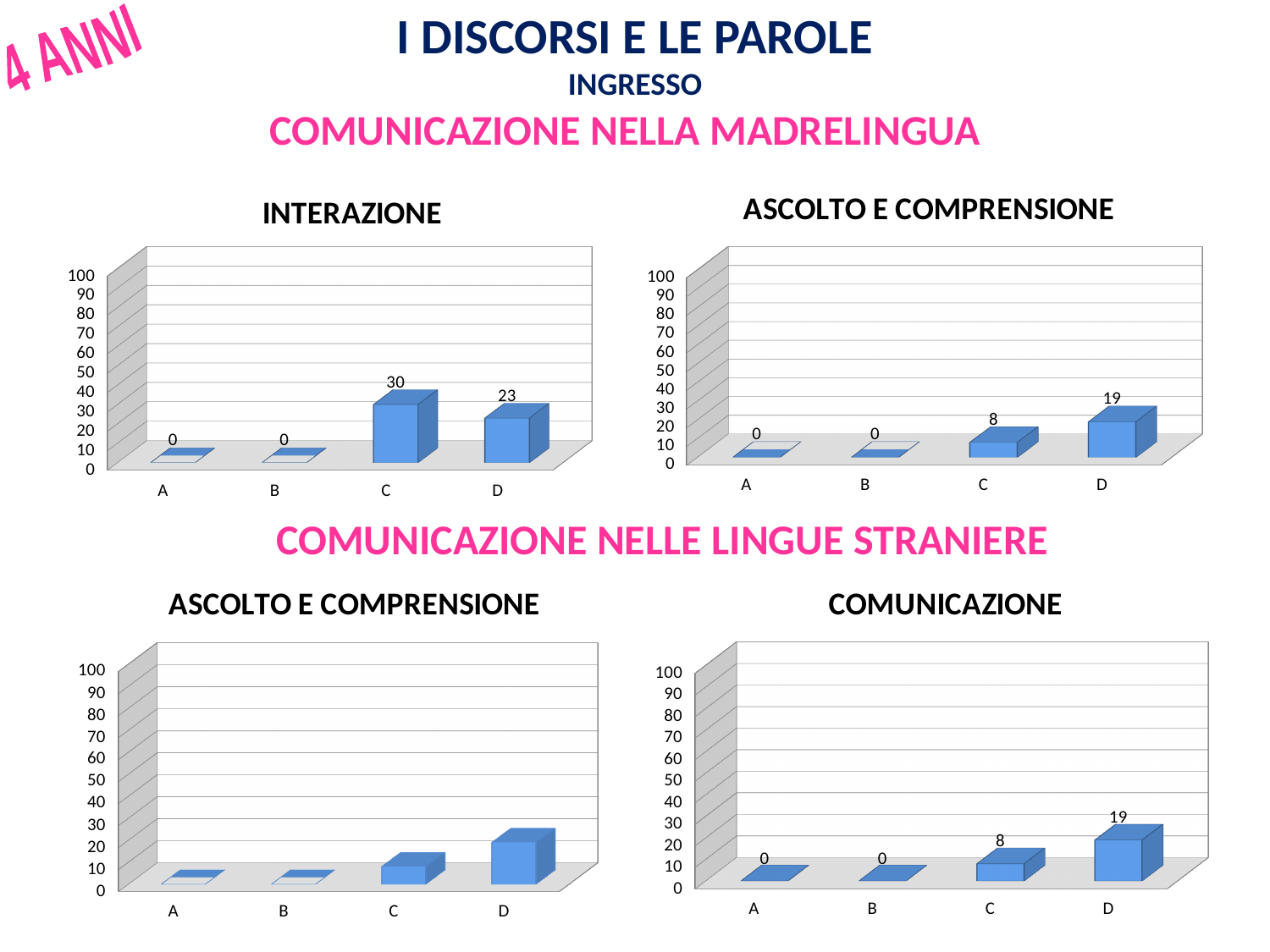
In the INTERAZIONE chart, what is the difference between the values for C and D? 7 In the ASCOLTO E COMPRENSIONE chart under COMUNICAZIONE NELLE LINGUE STRANIERE (bottom left), is the value for D greater or less than 10? greater In the INTERAZIONE chart, what is the value for C? 30 In the INTERAZIONE chart, what is the value for D? 23 In the INTERAZIONE chart, which category has the highest value? C In the ASCOLTO E COMPRENSIONE chart under COMUNICAZIONE NELLA MADRELINGUA (top right), what is the value for D? 19 In the ASCOLTO E COMPRENSIONE chart under COMUNICAZIONE NELLA MADRELINGUA (top right), what is the value for C? 8 In the COMUNICAZIONE chart (bottom right), what is the value for A? 0 In the COMUNICAZIONE chart (bottom right), what is the difference between the values for D and C? 11 How many categories are shown on the x axis of the INTERAZIONE chart? 4 What kind of chart is the COMUNICAZIONE chart (bottom right)? bar chart In the ASCOLTO E COMPRENSIONE chart under COMUNICAZIONE NELLA MADRELINGUA (top right), which is larger, C or D? D